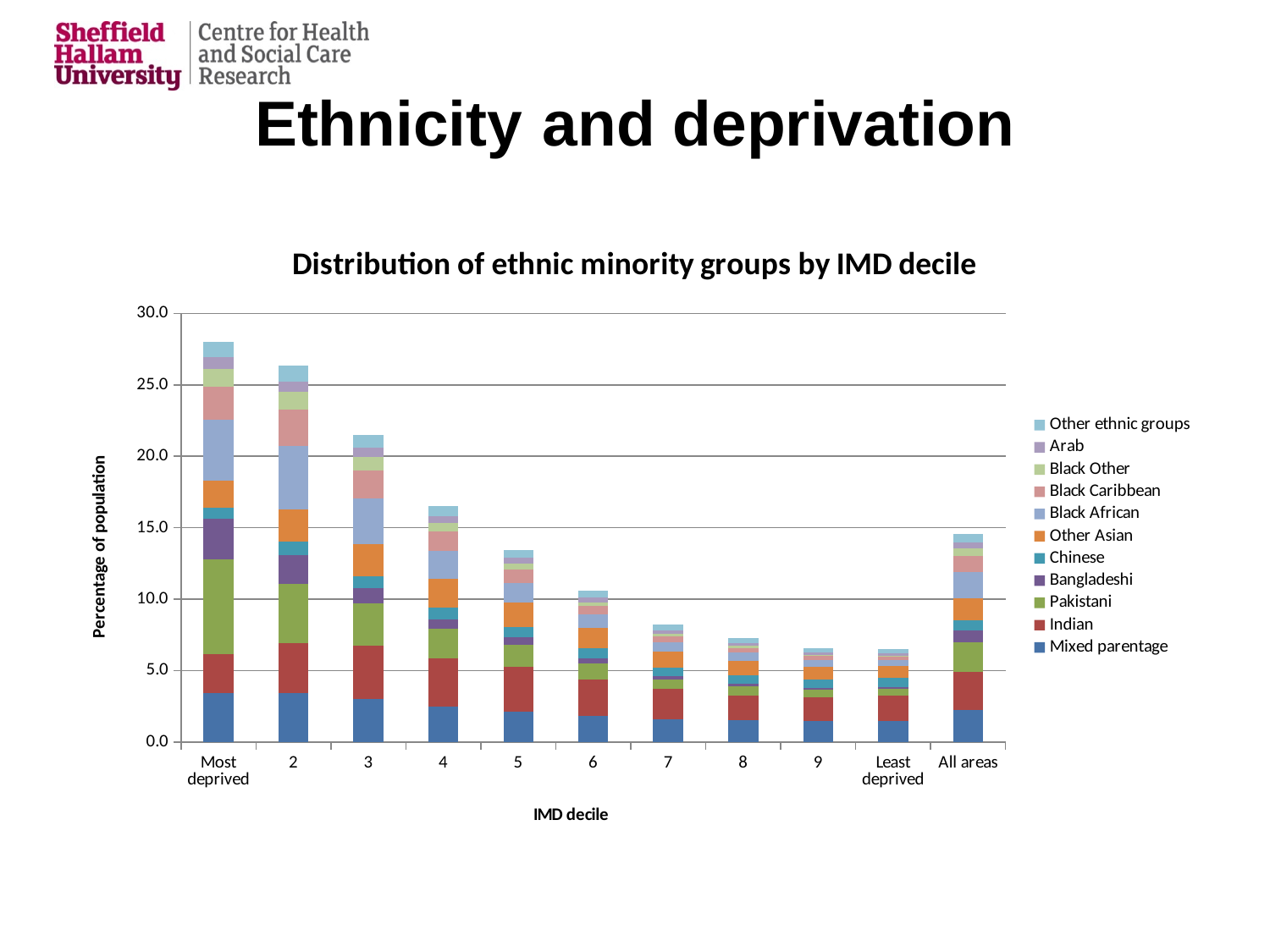
What is the label of the y axis? Percentage of population What is the title of the chart? Distribution of ethnic minority groups by IMD decile Is the total for the Most deprived decile greater or less than 25.0? greater How many series does the legend list? 11 What type of chart is shown on the slide? Stacked bar chart How many categories are shown along the x axis? 11 Do the total bar heights rise or fall moving from Most deprived to Least deprived along the x axis? fall Is the total for decile 8 greater or less than 10.0? less Is the total for All areas greater or less than 10.0? greater Which has the larger total bar, Most deprived or decile 2? Most deprived Which category has the highest total bar? Most deprived